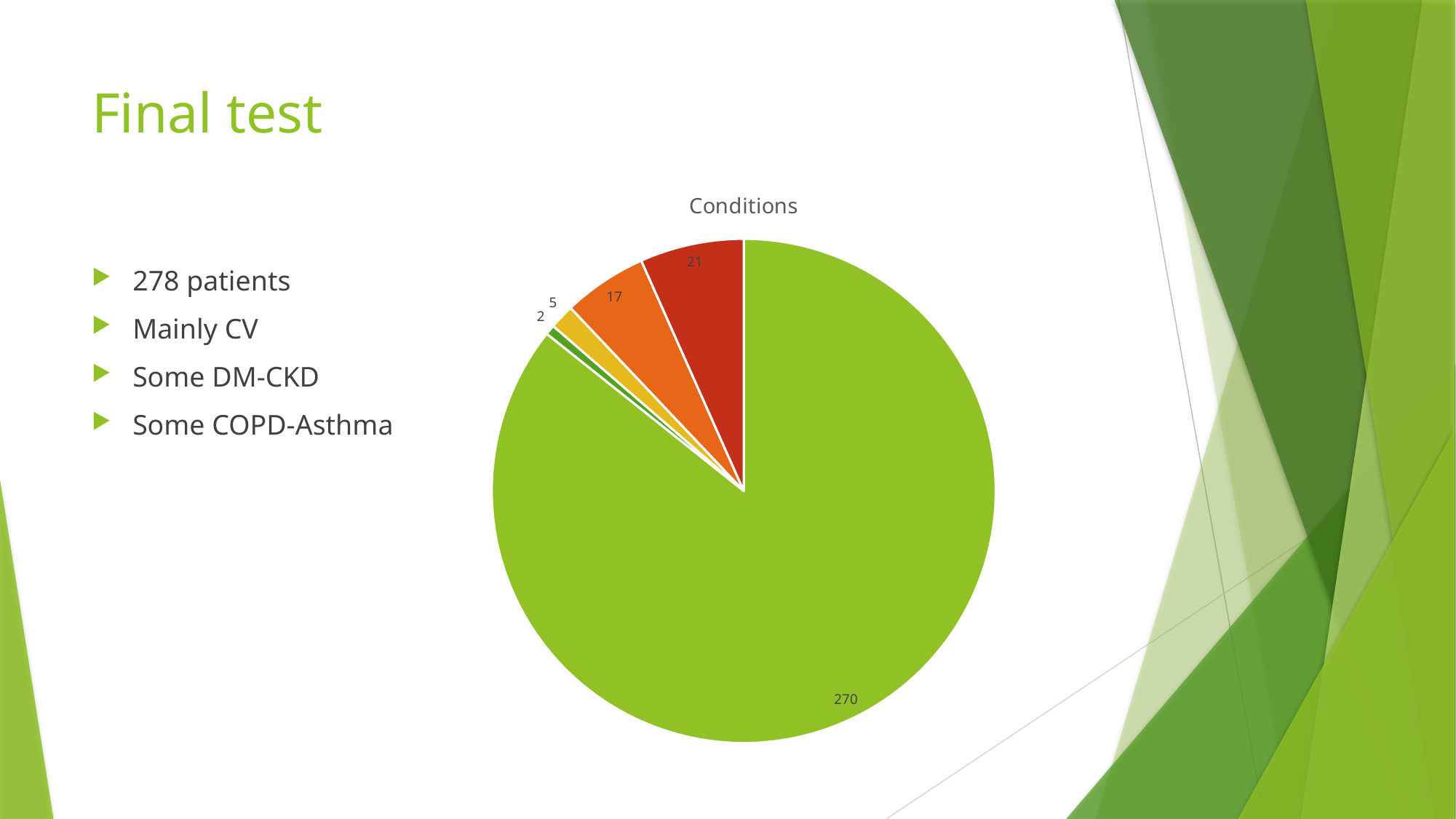
What is the value shown on the yellow slice of the pie chart? 5 What is the title of the chart? Conditions What is the difference between the largest slice (270) and the red slice (21)? 249 What is the value shown on the red slice of the pie chart? 21 What type of chart is shown on the slide? pie chart What is the total of all the slice values in the pie chart? 315 What colour is the largest slice of the pie chart? green Which is larger, the red slice or the orange slice? the red slice (21) What is the value shown on the orange slice of the pie chart? 17 What is the value of the largest slice in the pie chart? 270 What is the value of the smallest slice in the pie chart? 2 How many slices does the pie chart have? 5